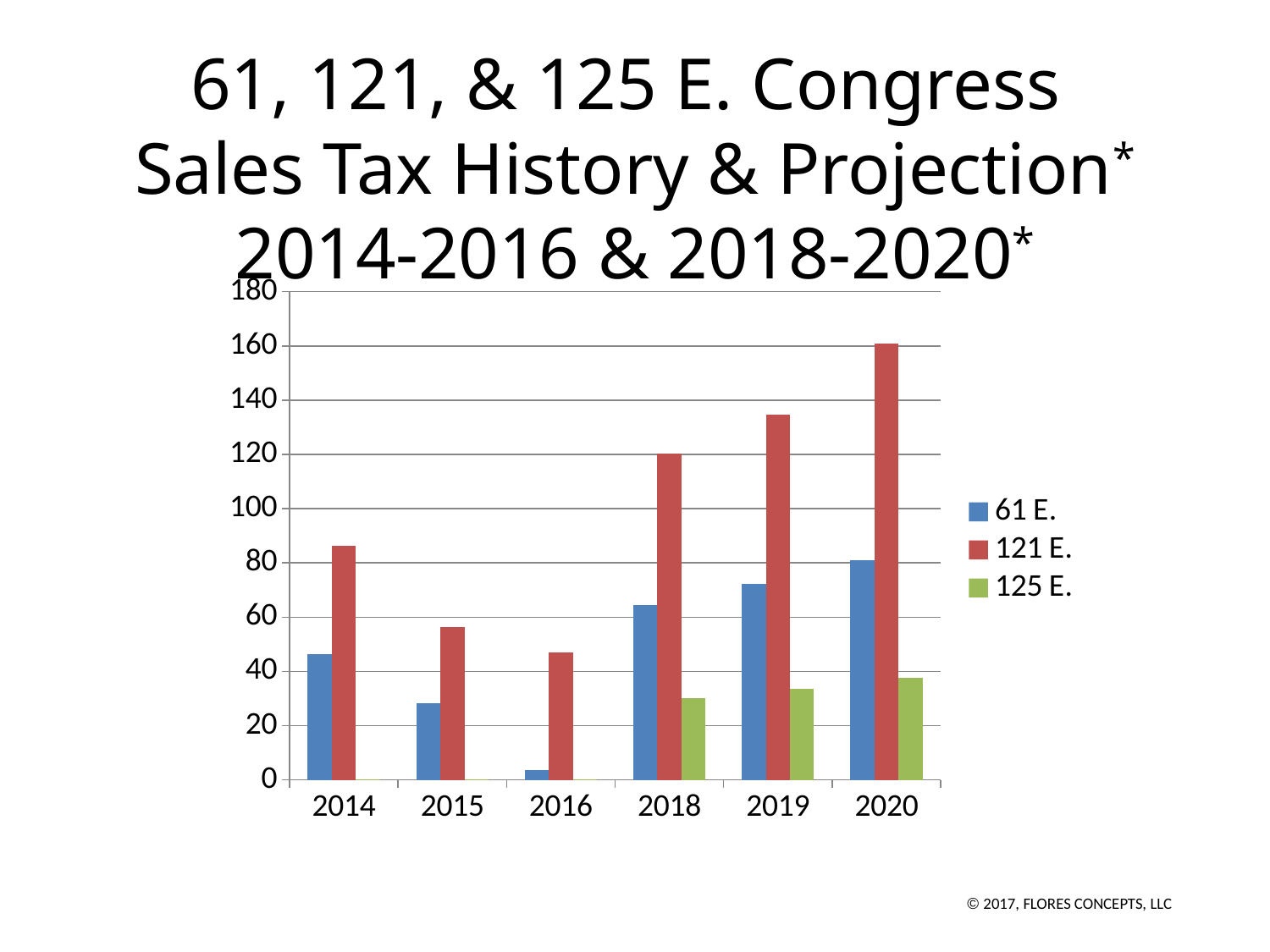
What are the three entries in the legend? 61 E., 121 E., 125 E. Is the value for 121 E. in 2019 greater or less than 120? greater Which series has no bars for 2014, 2015 and 2016? 125 E. What kind of chart is shown on the slide? bar chart How many series does the legend list? 3 How many years are shown along the x axis? 6 Is the value for 61 E. in 2014 greater or less than 60? less Do the values for 121 E. rise or fall from 2018 to 2020? rise In 2018, which is larger: the value for 61 E. or the value for 125 E.? 61 E. In which year is the value for 61 E. lowest? 2016 Is the value for 121 E. in 2020 greater or less than 140? greater In which year is the value for 121 E. highest? 2020